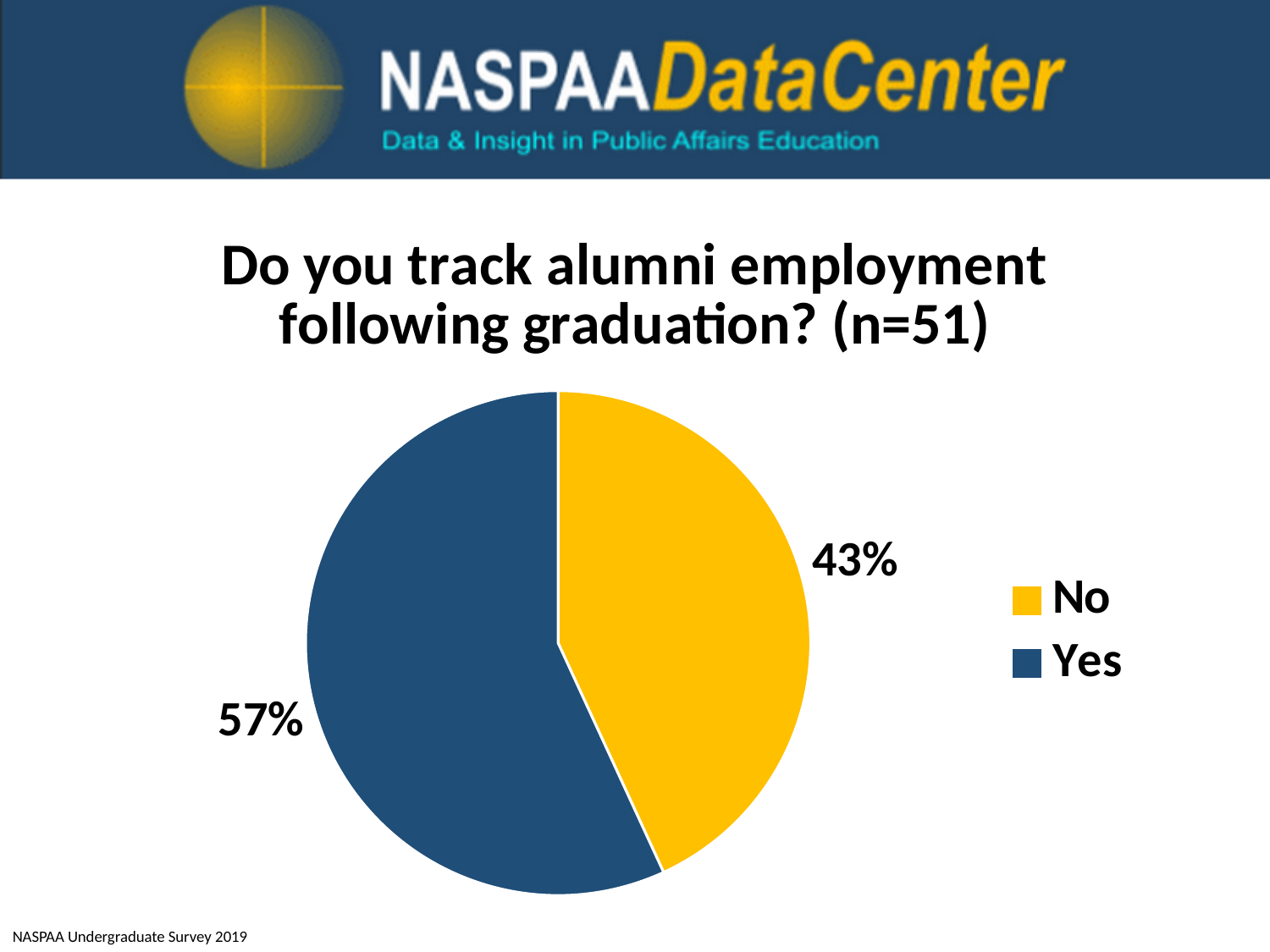
What is the sample size (n) given in the chart title? 51 How many slices does the pie chart have? 2 Is the share for "Yes" larger or smaller than the share for "No"? Larger Which colour represents the "No" response in the pie chart? Yellow What percentage of respondents answered "Yes"? 57% Which response has the smaller share of the pie? No What kind of chart is shown on the slide? Pie chart What is the difference in percentage points between the "Yes" and "No" shares? 14 percentage points What is the title of the chart? Do you track alumni employment following graduation? (n=51) Which response has the larger share of the pie? Yes What percentage of respondents answered "No"? 43% How many entries does the legend list? 2